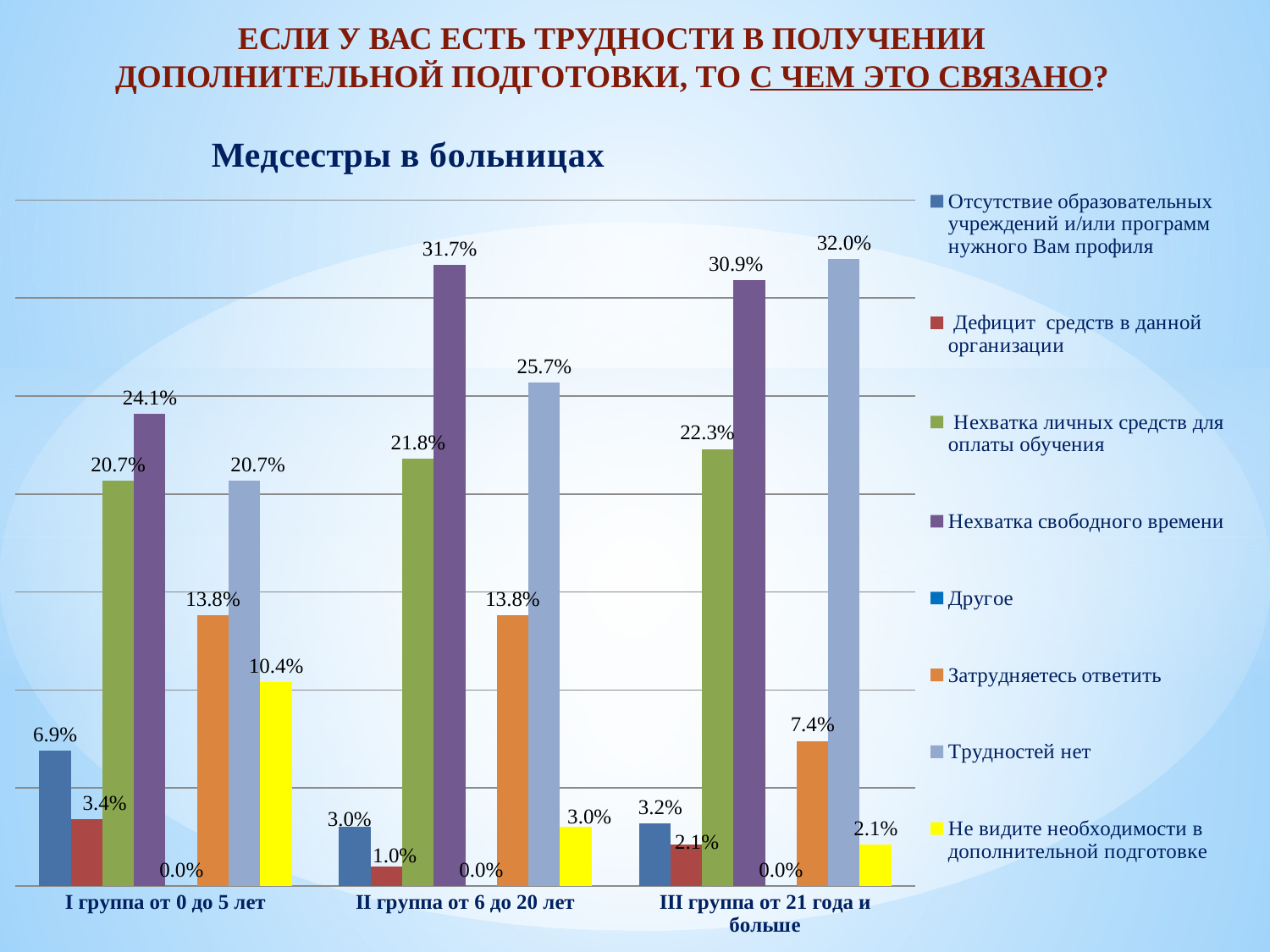
What is the value for "Трудностей нет" in the group "III группа от 21 года и больше"? 32.0% Which is larger in the group "III группа от 21 года и больше": "Затрудняетесь ответить" or "Нехватка личных средств для оплаты обучения"? Нехватка личных средств для оплаты обучения What is the difference between "Трудностей нет" and "Нехватка личных средств для оплаты обучения" in the group "II группа от 6 до 20 лет"? 3.9% Which series has the highest value in the group "I группа от 0 до 5 лет"? Нехватка свободного времени Which series has the highest value in the group "III группа от 21 года и больше"? Трудностей нет What is the value for "Не видите необходимости в дополнительной подготовке" in the group "I группа от 0 до 5 лет"? 10.4% What is the subtitle of the chart? Медсестры в больницах Which series has the lowest value in the group "II группа от 6 до 20 лет"? Другое How many age groups are shown on the x axis? 3 How many series does the legend list? 8 What is the value for "Нехватка свободного времени" in the group "II группа от 6 до 20 лет"? 31.7% What kind of chart is shown on the slide? Bar chart